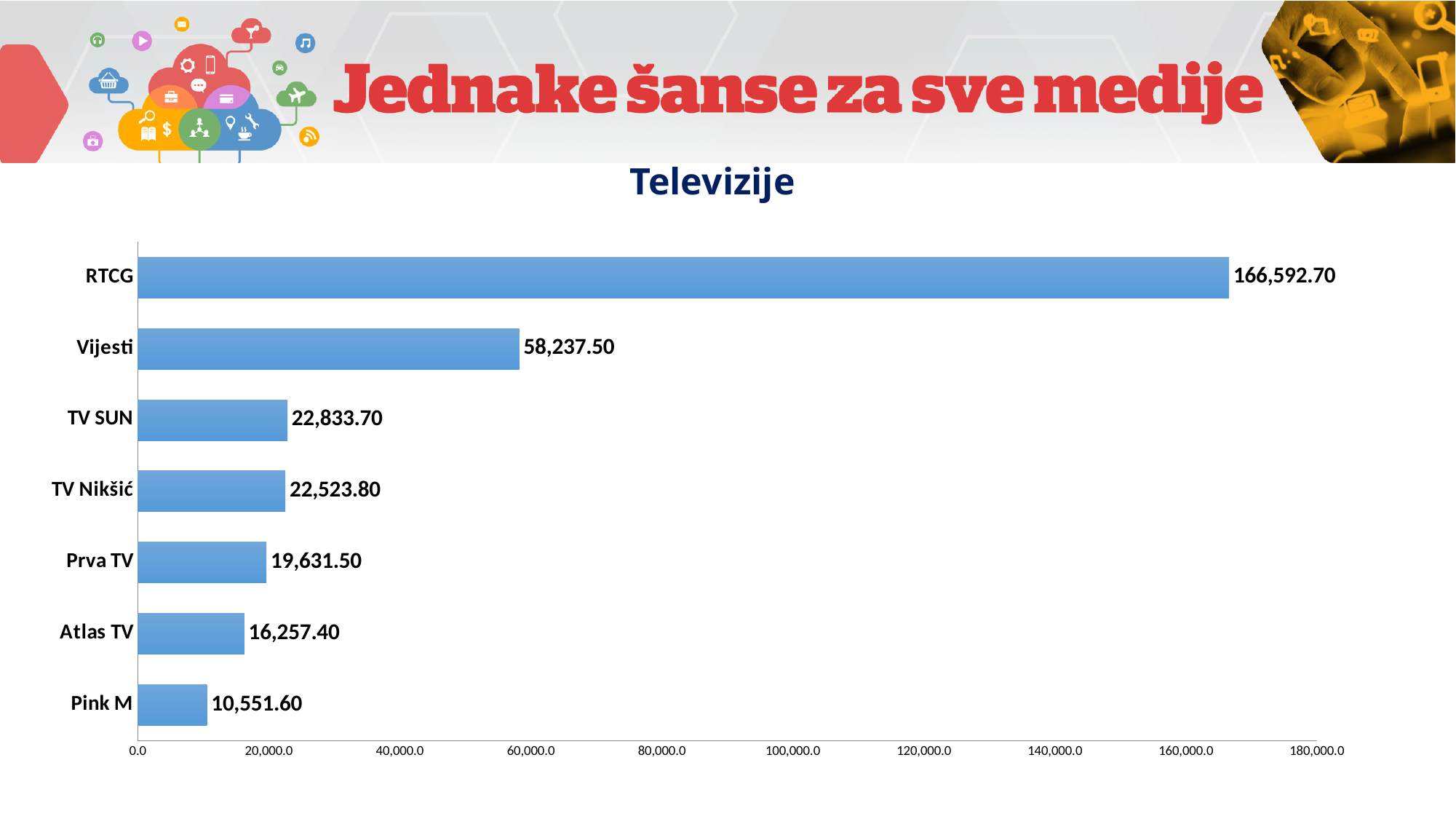
What is the difference between the values for RTCG and Vijesti? 108,355.20 What type of chart is shown on the slide? Bar chart What is the value for Vijesti? 58,237.50 How many categories are shown in the chart? 7 What is the difference between the values for Atlas TV and Pink M? 5,705.80 Which has a larger value, Vijesti or TV SUN? Vijesti Which category has the lowest value? Pink M What is the value for Pink M? 10,551.60 What is the value for RTCG? 166,592.70 Is the value for Vijesti greater or less than 40,000.0? greater Which category has the highest value? RTCG What is the value for Prva TV? 19,631.50